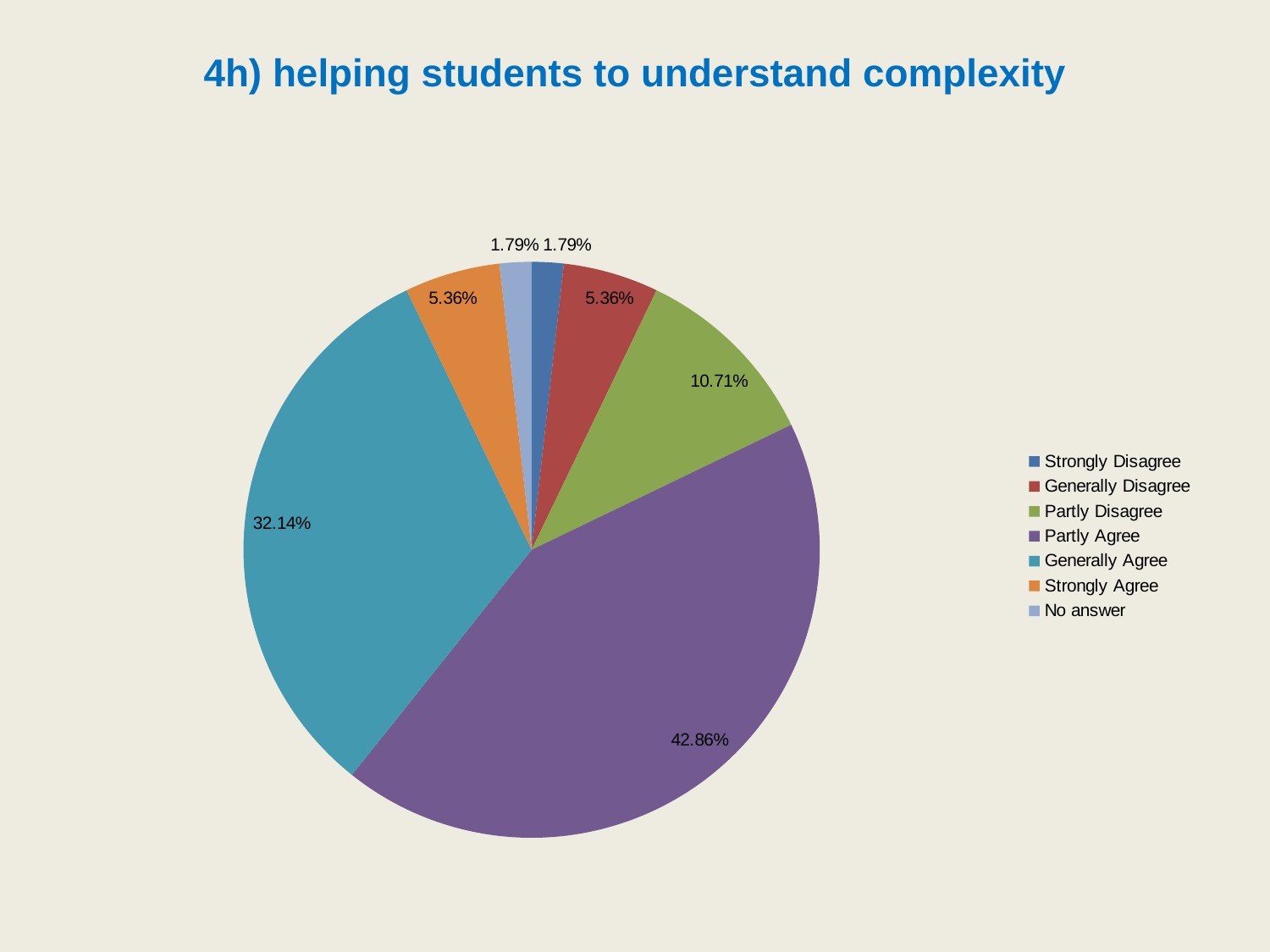
What is the value for No answer? 1.79% Which is larger, Partly Agree or Generally Agree? Partly Agree What is the title of the chart? 4h) helping students to understand complexity What kind of chart is shown on the slide? pie chart What is the value for Strongly Agree? 5.36% How many categories does the legend list? 7 Which category has the largest slice of the pie? Partly Agree What is the value for Generally Agree? 32.14% What is the difference between the Partly Agree and Generally Agree values? 10.72% What is the value for Partly Disagree? 10.71% What share of the pie does Partly Agree take? 42.86% What is the value for Generally Disagree? 5.36%